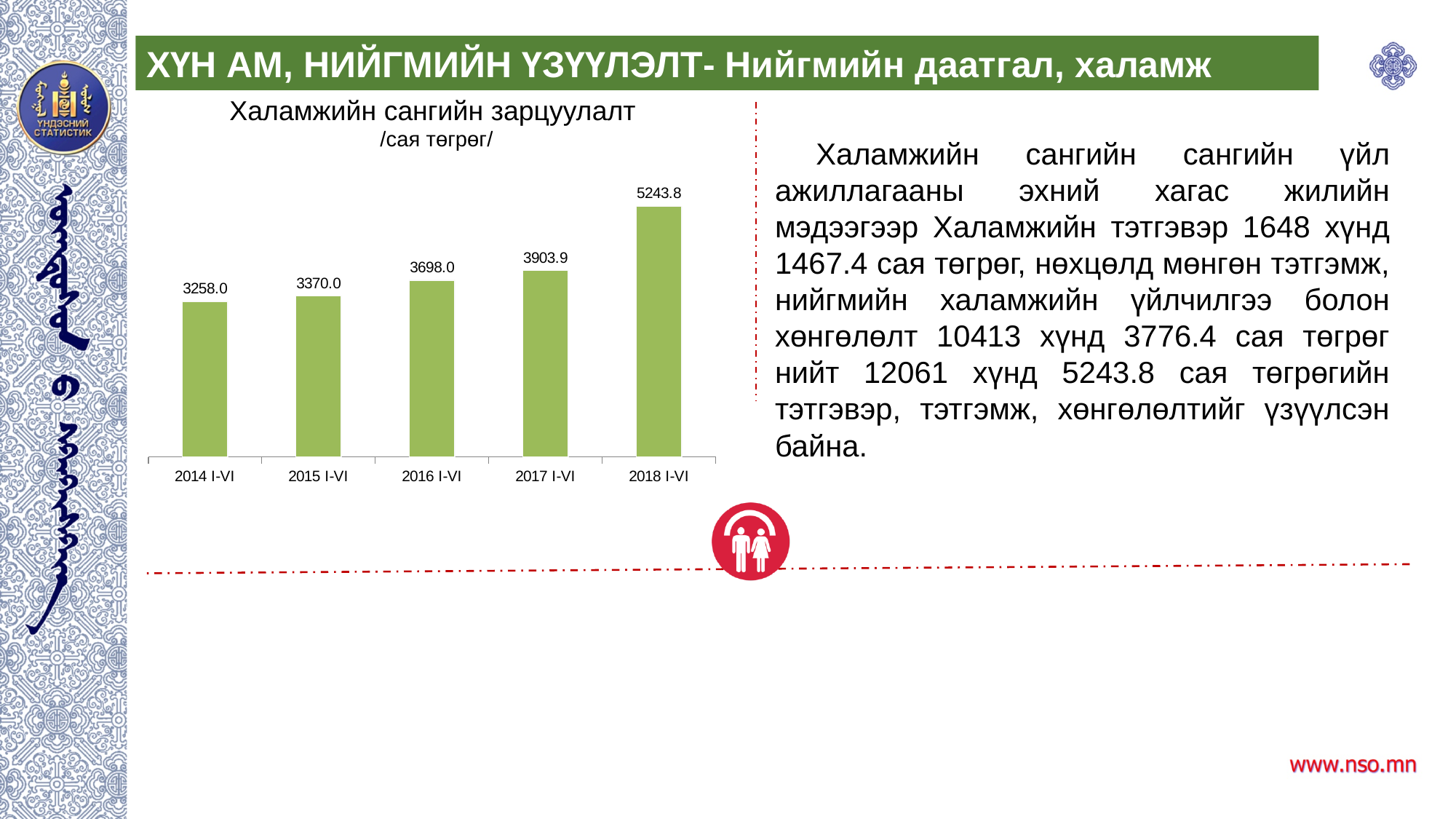
How many periods are shown on the chart? 5 Which is larger, the value for 2016 I-VI or 2017 I-VI? 2017 I-VI What is the value for 2016 I-VI? 3698.0 Which period has the lowest value? 2014 I-VI What is the difference between the values for 2015 I-VI and 2014 I-VI? 112.0 What kind of chart is shown? Bar chart What is the difference between the values for 2018 I-VI and 2017 I-VI? 1339.9 Which period has the highest value? 2018 I-VI What is the value for 2018 I-VI? 5243.8 What is the value for 2014 I-VI? 3258.0 Do the values rise or fall from 2014 I-VI to 2018 I-VI? Rise What unit is given under the chart title? сая төгрөг